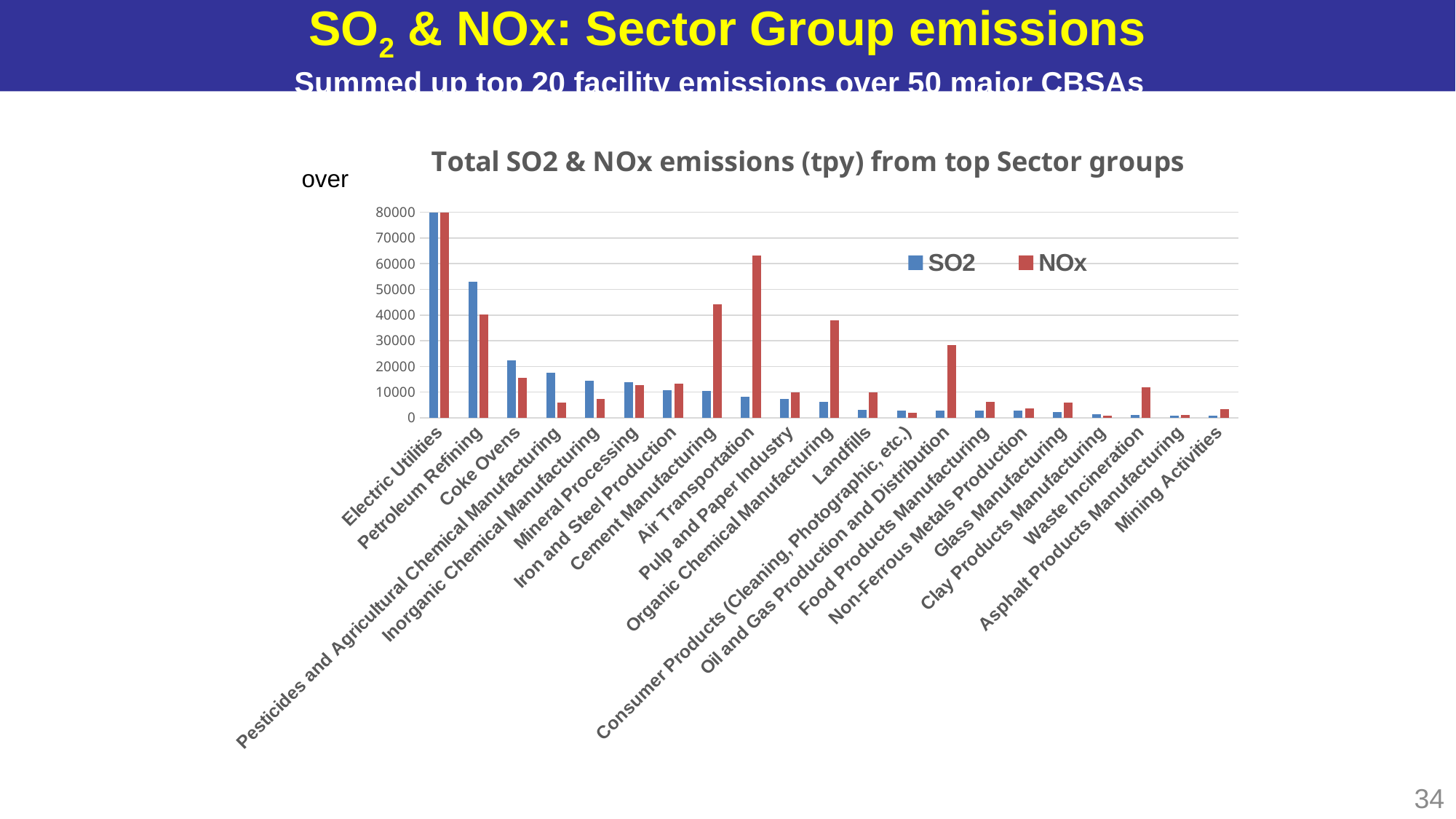
How many series does the legend list? 2 What are the two series named in the legend? SO2 and NOx Do the SO2 values generally rise or fall moving left to right along the x axis? fall Is the SO2 value for Petroleum Refining greater or less than 50000? greater For Coke Ovens, which is larger, SO2 or NOx emissions? SO2 Is the NOx value for Air Transportation greater or less than 60000? greater What kind of chart is shown on the slide? bar chart For Air Transportation, which is larger, SO2 or NOx emissions? NOx Which sector group has the highest SO2 emissions? Electric Utilities How many sector groups are shown on the x axis? 21 Which sector group has the highest NOx emissions? Electric Utilities